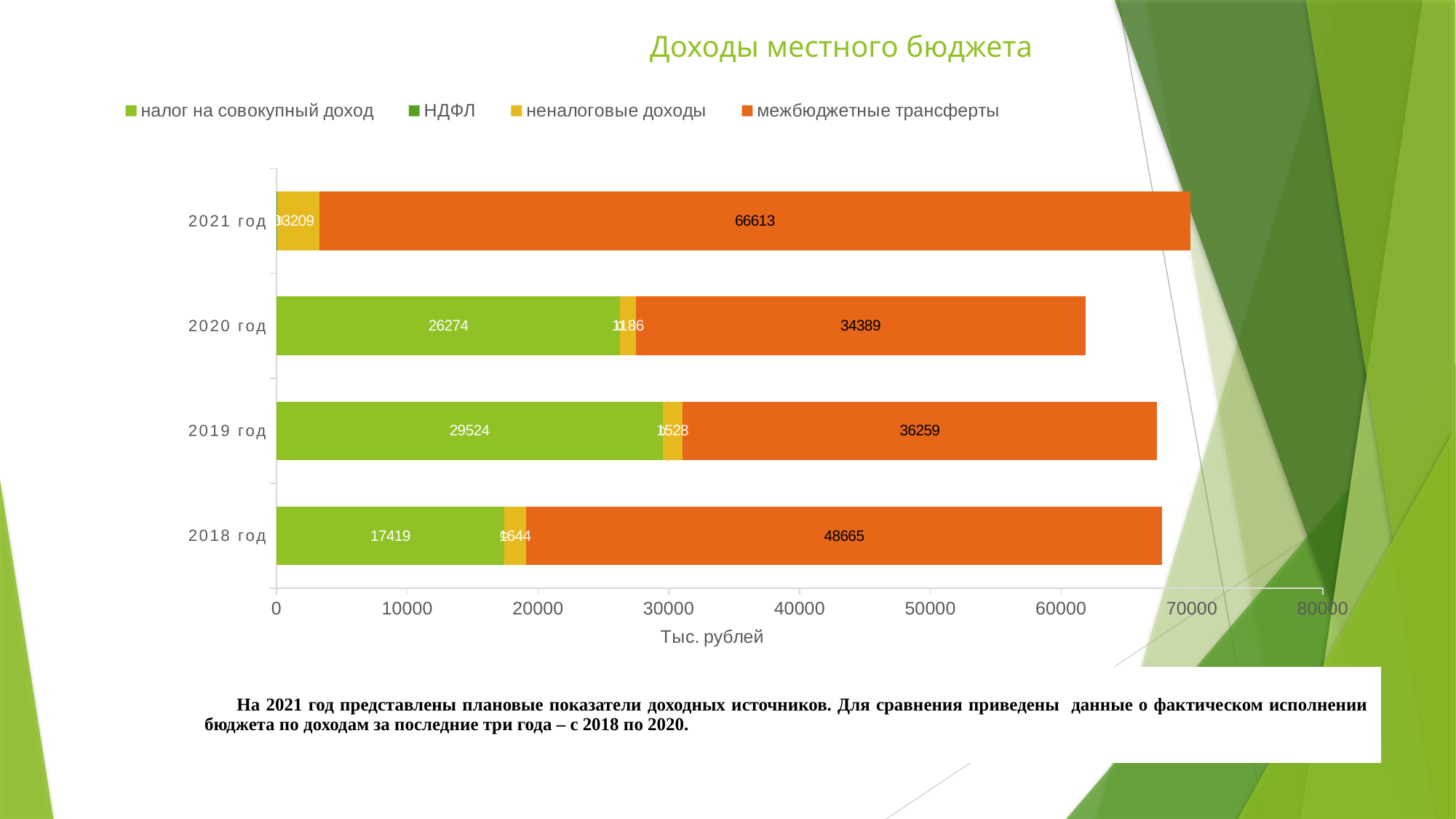
How many series does the legend list? 4 Which year has the larger value of налог на совокупный доход, 2019 год or 2020 год? 2019 год What is the difference between межбюджетные трансферты in 2021 год and 2020 год? 32224 Is the total length of the 2020 год bar greater or less than 60000? greater What is the value of межбюджетные трансферты for 2018 год? 48665 In which year is межбюджетные трансферты the lowest? 2020 год In which year is межбюджетные трансферты the highest? 2021 год What is the value of налог на совокупный доход for 2020 год? 26274 What type of chart is shown on the slide? Stacked bar chart What is the value of межбюджетные трансферты for 2021 год? 66613 How many years (categories) are shown on the chart? 4 What is the title of the chart? Доходы местного бюджета